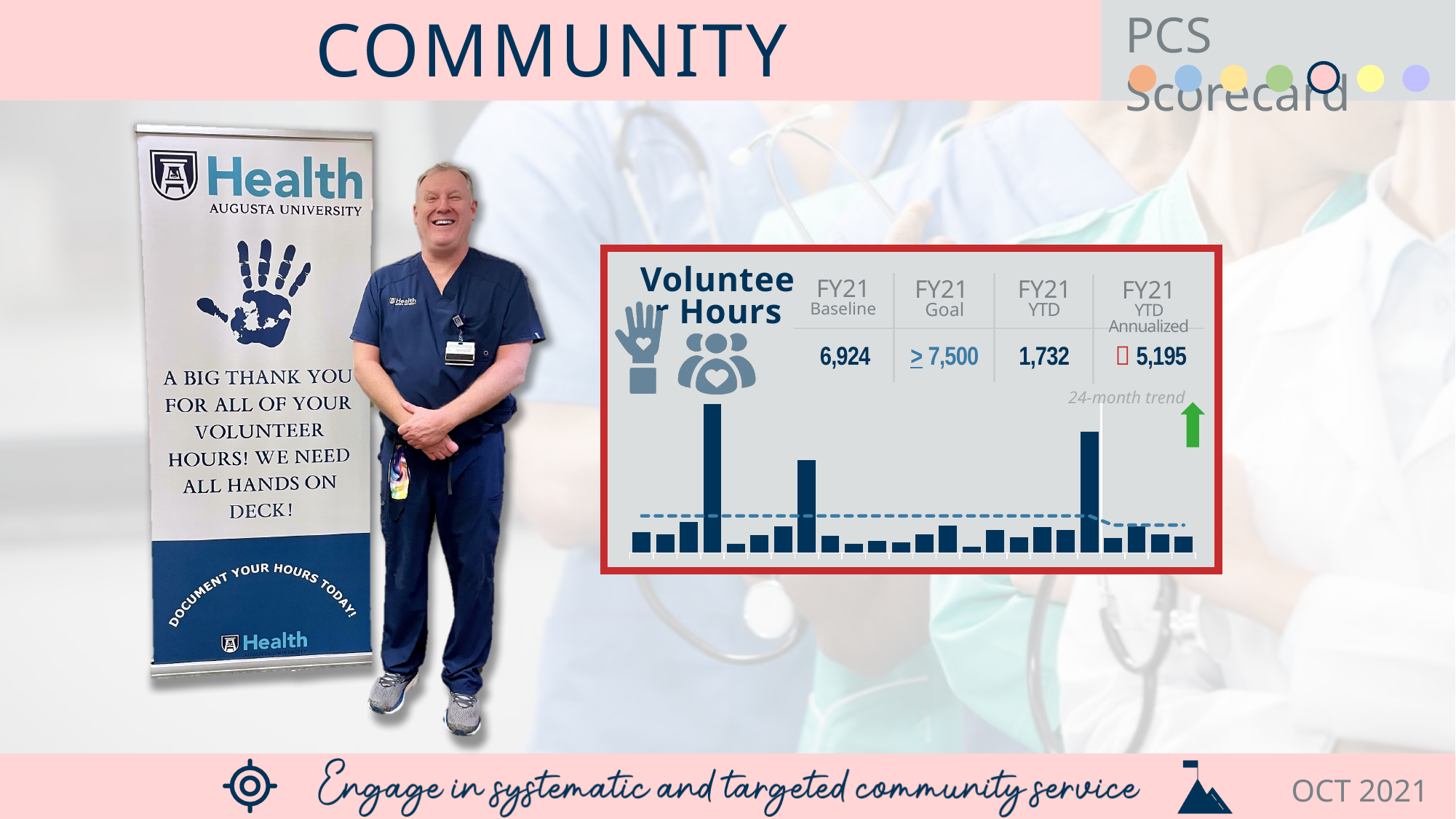
What period does the trend chart on the Volunteer Hours panel cover, according to its label? 24-month trend What is the FY21 Baseline value shown on the Volunteer Hours chart? 6,924 What is the FY21 Goal shown on the Volunteer Hours chart? ≥ 7,500 On the Volunteer Hours chart, is the FY21 YTD Annualized value greater or less than the FY21 Goal of 7,500? less On the Volunteer Hours chart, which is larger: the FY21 Baseline or the FY21 YTD Annualized value? FY21 Baseline What is the FY21 YTD Annualized value shown on the Volunteer Hours chart? 5,195 What is the title of the chart panel outlined in red on the slide? Volunteer Hours How many bars are plotted in the 24-month trend on the Volunteer Hours chart? 24 On the Volunteer Hours chart, what is the difference between the FY21 Baseline (6,924) and the FY21 YTD Annualized value (5,195)? 1,729 What is the FY21 YTD value shown on the Volunteer Hours chart? 1,732 What kind of chart is used to show the 24-month trend on the Volunteer Hours panel? combination bar and line chart (bars with a dashed goal line) Which direction does the green arrow next to the 24-month trend on the Volunteer Hours chart point? up